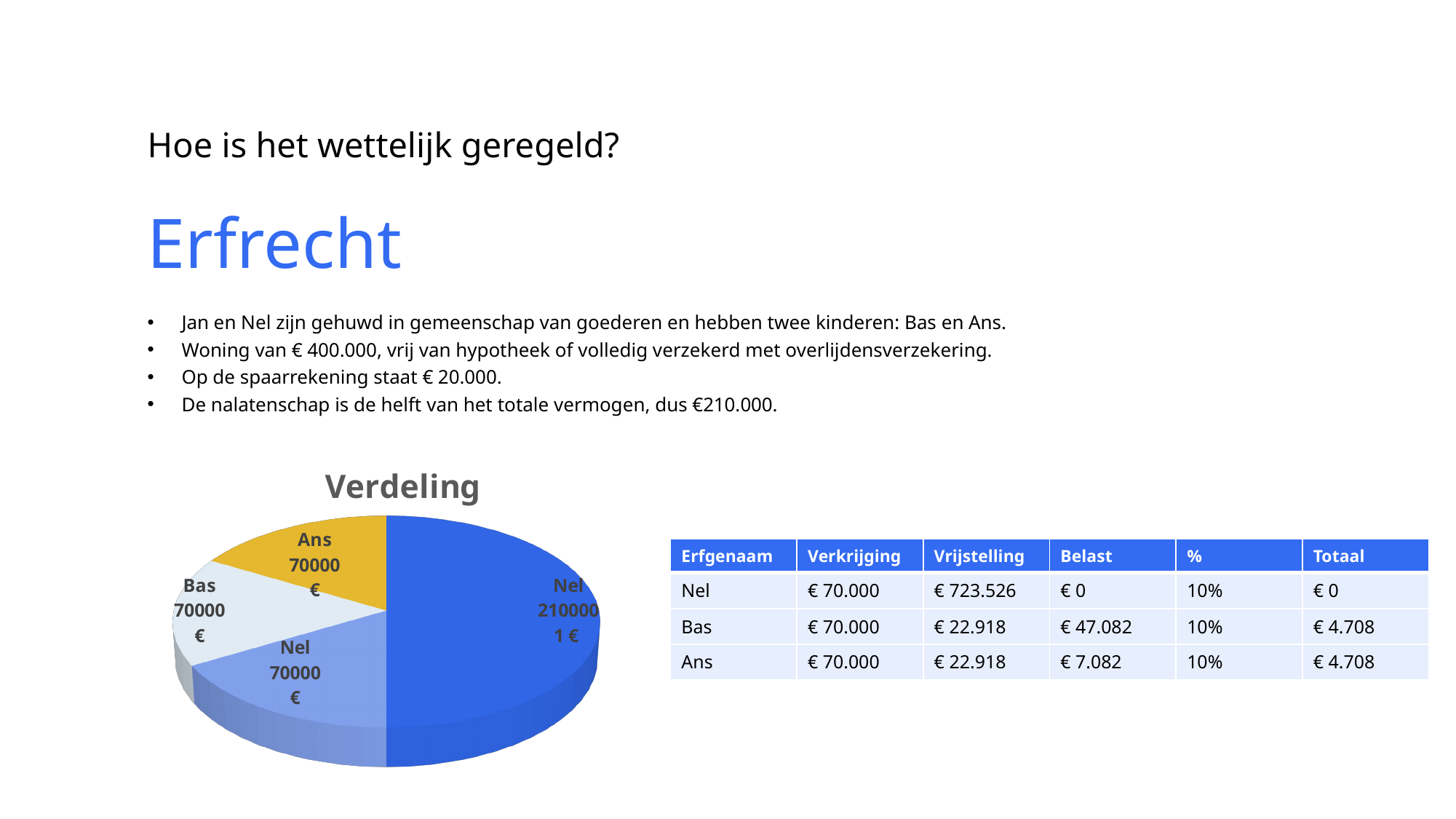
How many slices does the pie chart have? 4 What kind of chart is shown on the slide? pie chart Which slice is the largest in the pie chart? Nel What is the title of the chart? Verdeling Which is larger in the pie chart: the large Nel slice or the Bas slice? Nel What value is shown for the Bas slice in the pie chart? 70000 € What colour is the Ans slice in the pie chart? yellow What value is shown for the Ans slice in the pie chart? 70000 € Which is larger in the pie chart: the Ans slice or the large Nel slice? Nel